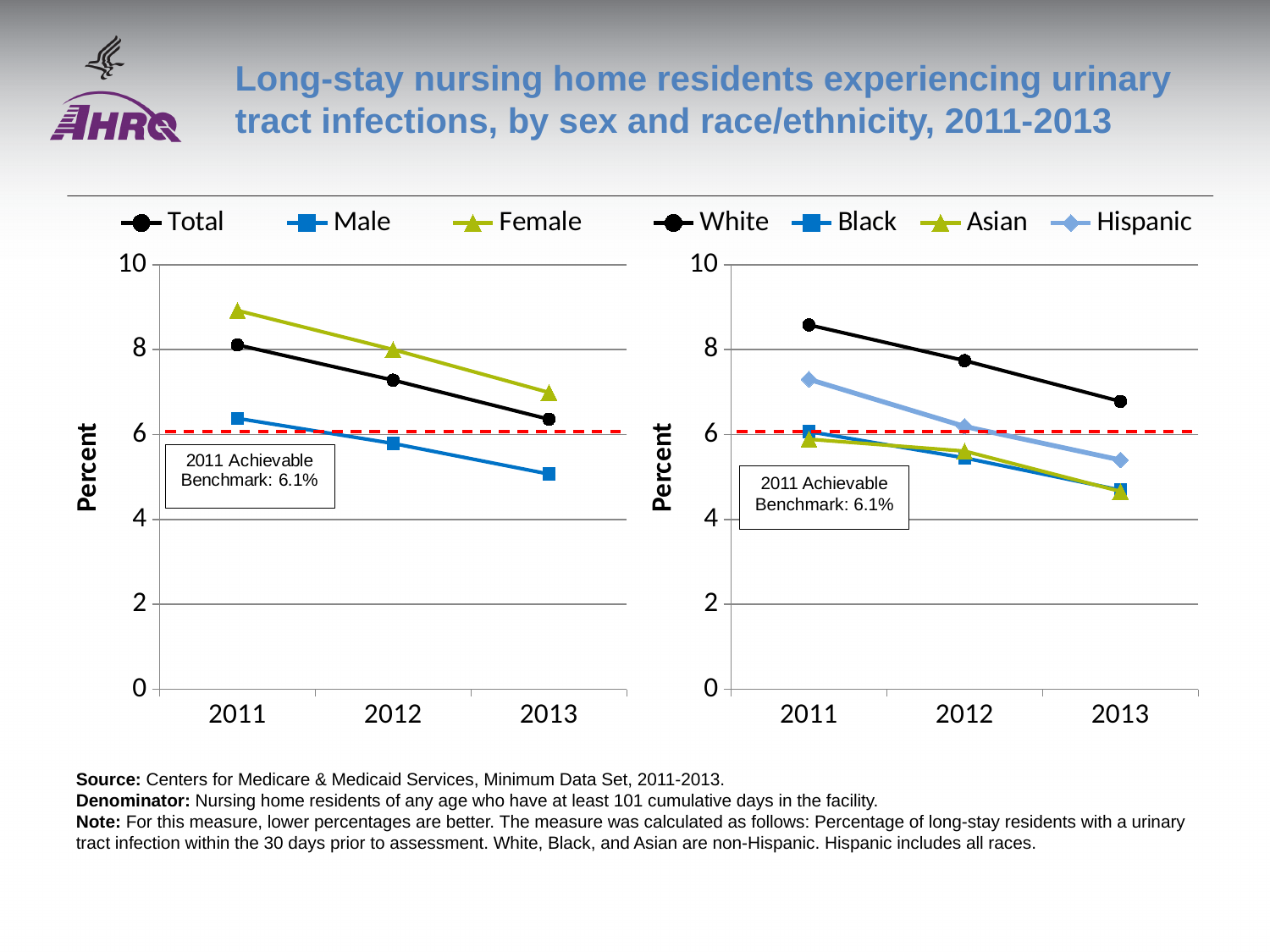
How many series does the legend of the left chart (Total, Male, Female) list? 3 In the left chart (Total, Male, Female), is the value for Male in 2013 greater or less than 6? less How many years are shown on the x axis of the left chart (Total, Male, Female)? 3 How many series does the legend of the right chart (White, Black, Asian, Hispanic) list? 4 In the left chart (Total, Male, Female), is the value for Female in 2011 greater or less than 8? greater What is the 2011 Achievable Benchmark shown on the charts? 6.1% What kind of chart is the left chart (Total, Male, Female)? line chart In the right chart (White, Black, Asian, Hispanic), is the value for White in 2013 greater or less than 6? greater In the left chart (Total, Male, Female), does the Female line rise or fall from 2011 to 2013? fall In the left chart (Total, Male, Female), which is larger in 2012, the value for Female or the value for Male? Female In the right chart (White, Black, Asian, Hispanic), which series has the highest value in 2011? White In the right chart (White, Black, Asian, Hispanic), does the White line rise or fall from 2011 to 2013? fall